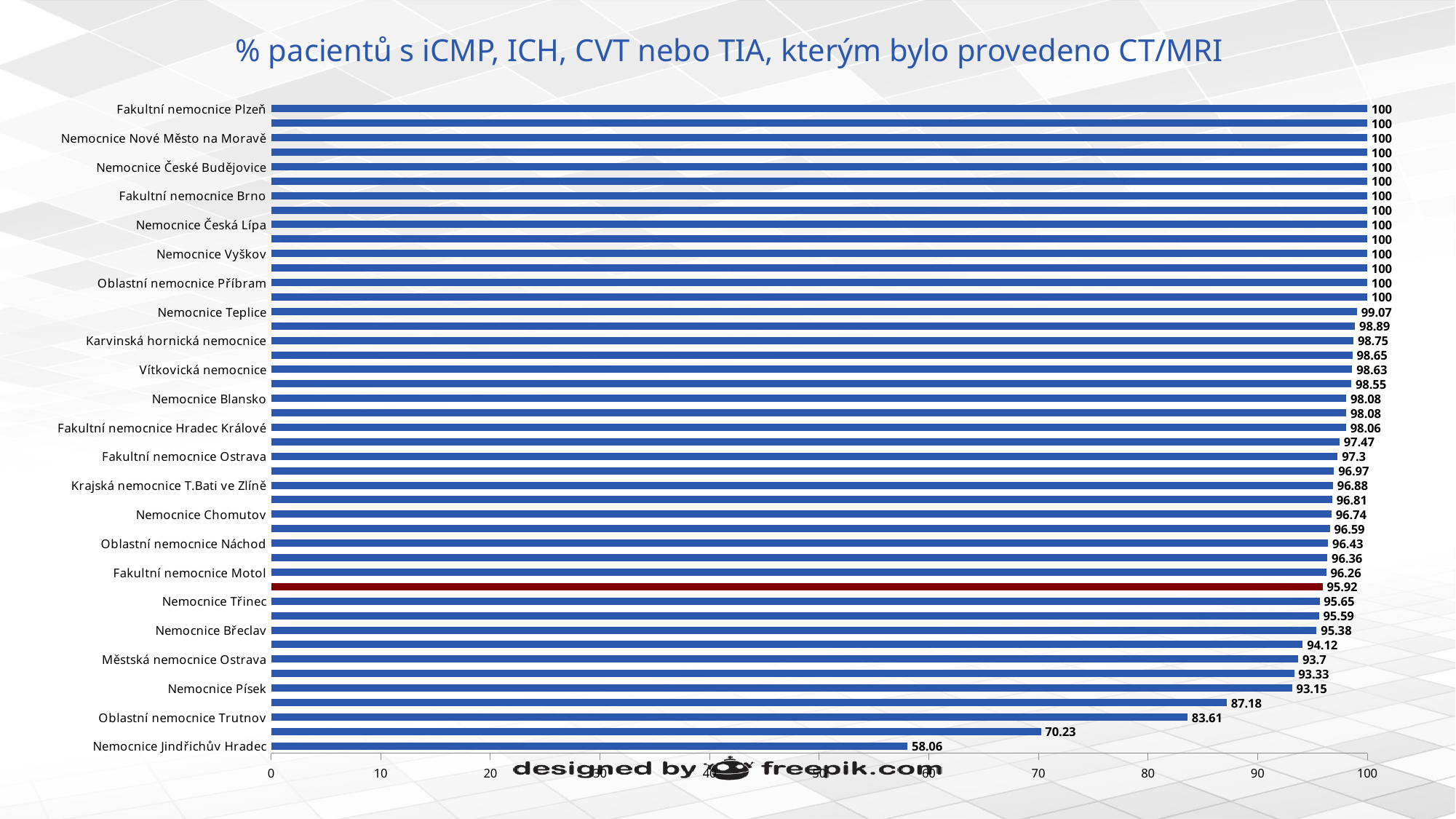
What is the difference between the values for Oblastní nemocnice Trutnov and Nemocnice Jindřichův Hradec? 25.55 What kind of chart is shown on the slide? bar chart What is the value for Oblastní nemocnice Trutnov? 83.61 What is the value for Nemocnice Písek? 93.15 Which is larger, the value for Nemocnice Břeclav or the value for Městská nemocnice Ostrava? Nemocnice Břeclav Is the value for Nemocnice Jindřichův Hradec greater or less than 60? less What is the value for Nemocnice Teplice? 99.07 What is the value of the bar highlighted in red? 95.92 What is the value for Nemocnice Jindřichův Hradec? 58.06 What is the value for Fakultní nemocnice Motol? 96.26 Which hospital has the lowest value on the chart? Nemocnice Jindřichův Hradec What is the value for Fakultní nemocnice Plzeň? 100